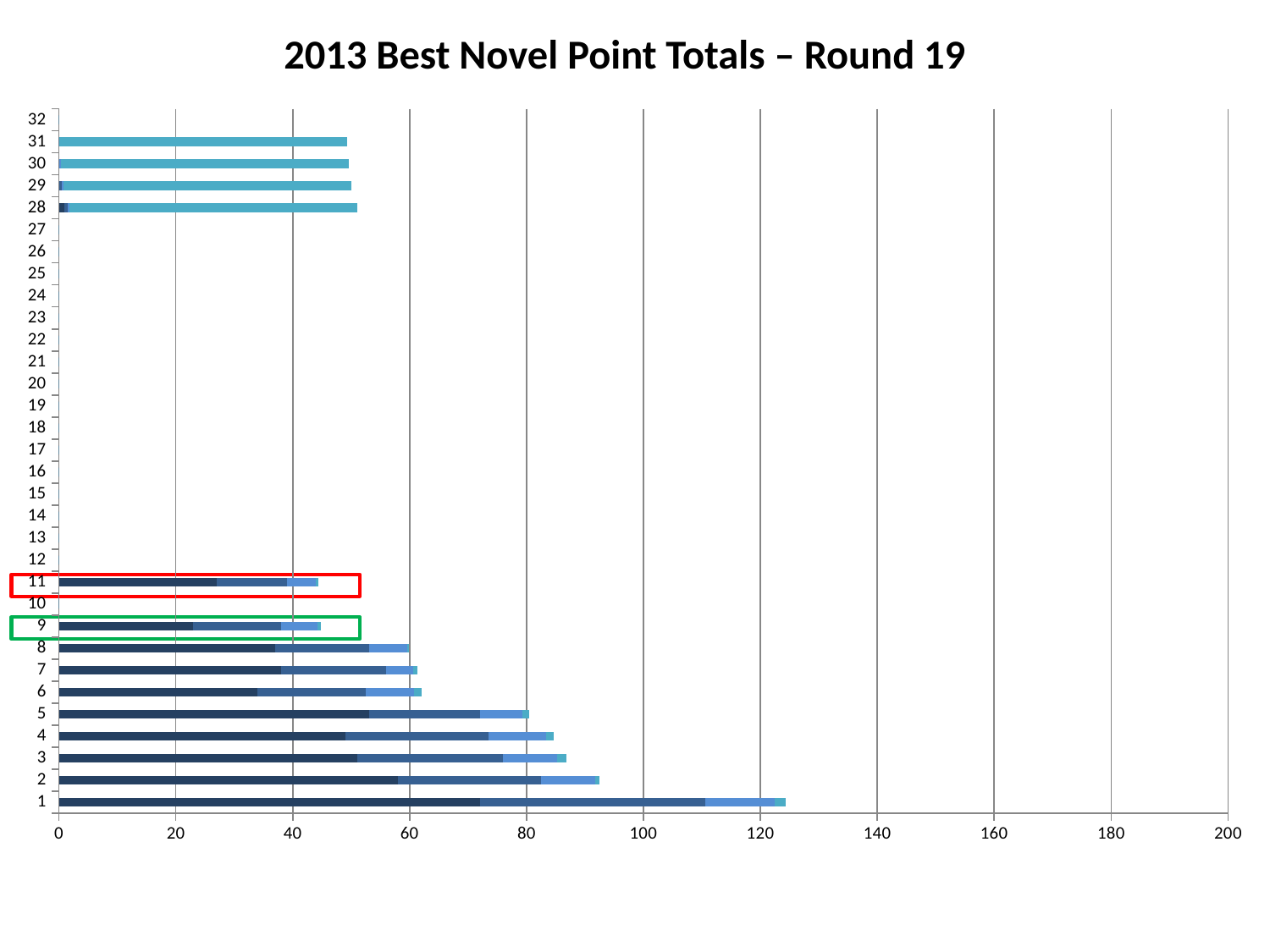
What kind of chart is shown on the slide? Bar chart Is the total value for category 1 greater or less than 100? greater Which category has the longest bar in the chart? 1 Which has a larger total value, category 5 or category 9? Category 5 Which category label is outlined with a red box on the chart? 11 Is the total value for category 28 greater or less than 40? greater Is the total value for category 2 greater or less than 100? less How many categories are listed on the vertical axis of the chart? 32 What is the title of the chart? 2013 Best Novel Point Totals – Round 19 Which has a larger total value, category 1 or category 2? Category 1